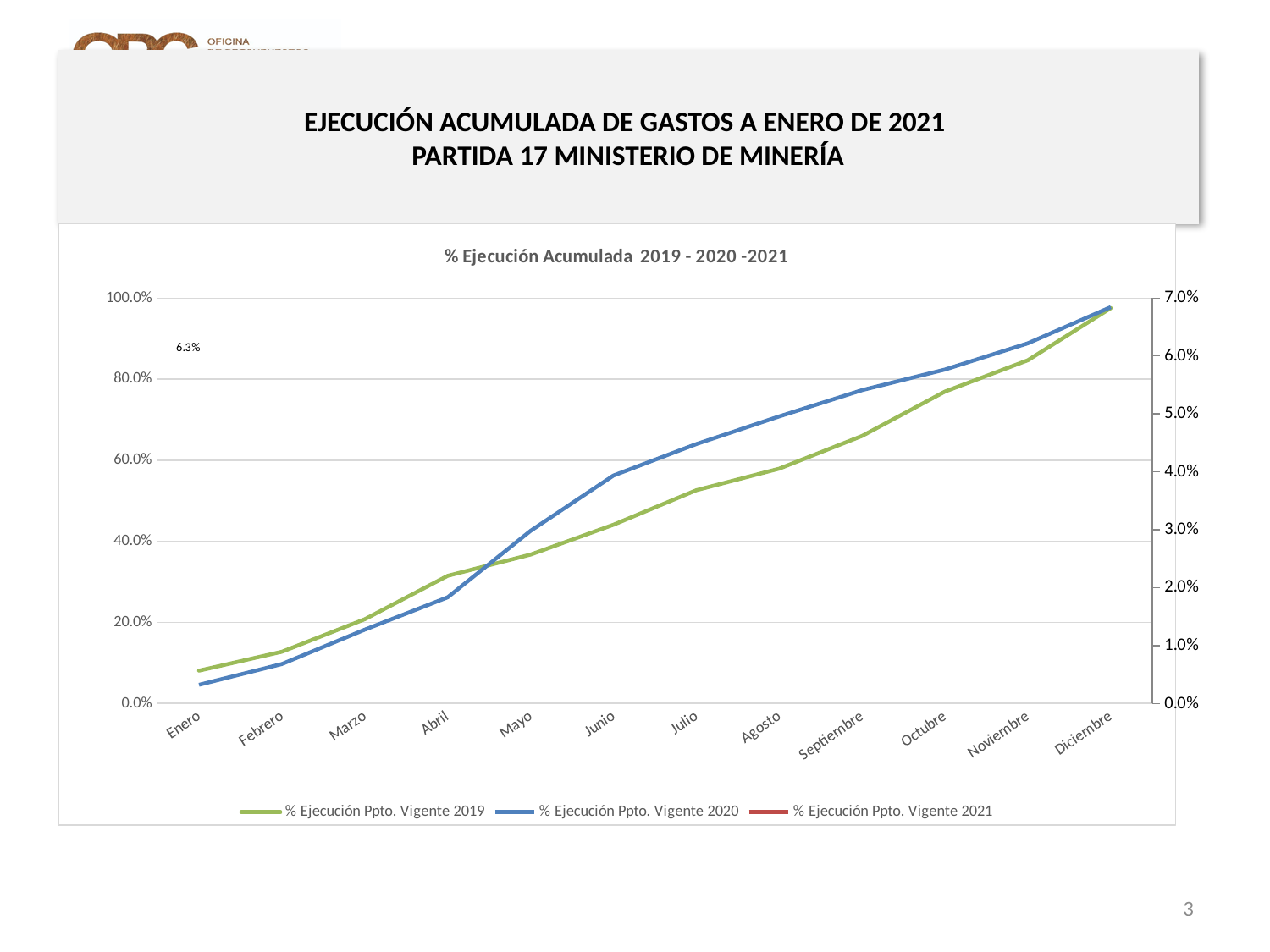
Do the values for % Ejecución Ppto. Vigente 2020 rise or fall from Enero to Diciembre? Rise In which month is the % Ejecución Ppto. Vigente 2019 series at its highest? Diciembre Is the value for % Ejecución Ppto. Vigente 2019 in Abril greater or less than 40.0%? less Is the value for % Ejecución Ppto. Vigente 2020 in Junio greater or less than 40.0%? greater In Junio, which series is higher: % Ejecución Ppto. Vigente 2019 or % Ejecución Ppto. Vigente 2020? % Ejecución Ppto. Vigente 2020 What value is printed as the data label for Enero on the % Ejecución Ppto. Vigente 2021 series? 6.3% How many series does the legend list? 3 What kind of chart is shown on the slide? Line chart In Abril, which series is higher: % Ejecución Ppto. Vigente 2019 or % Ejecución Ppto. Vigente 2020? % Ejecución Ppto. Vigente 2019 In which month is the % Ejecución Ppto. Vigente 2020 series at its lowest? Enero What is the title of the chart? % Ejecución Acumulada 2019 - 2020 -2021 How many months are shown along the x axis? 12